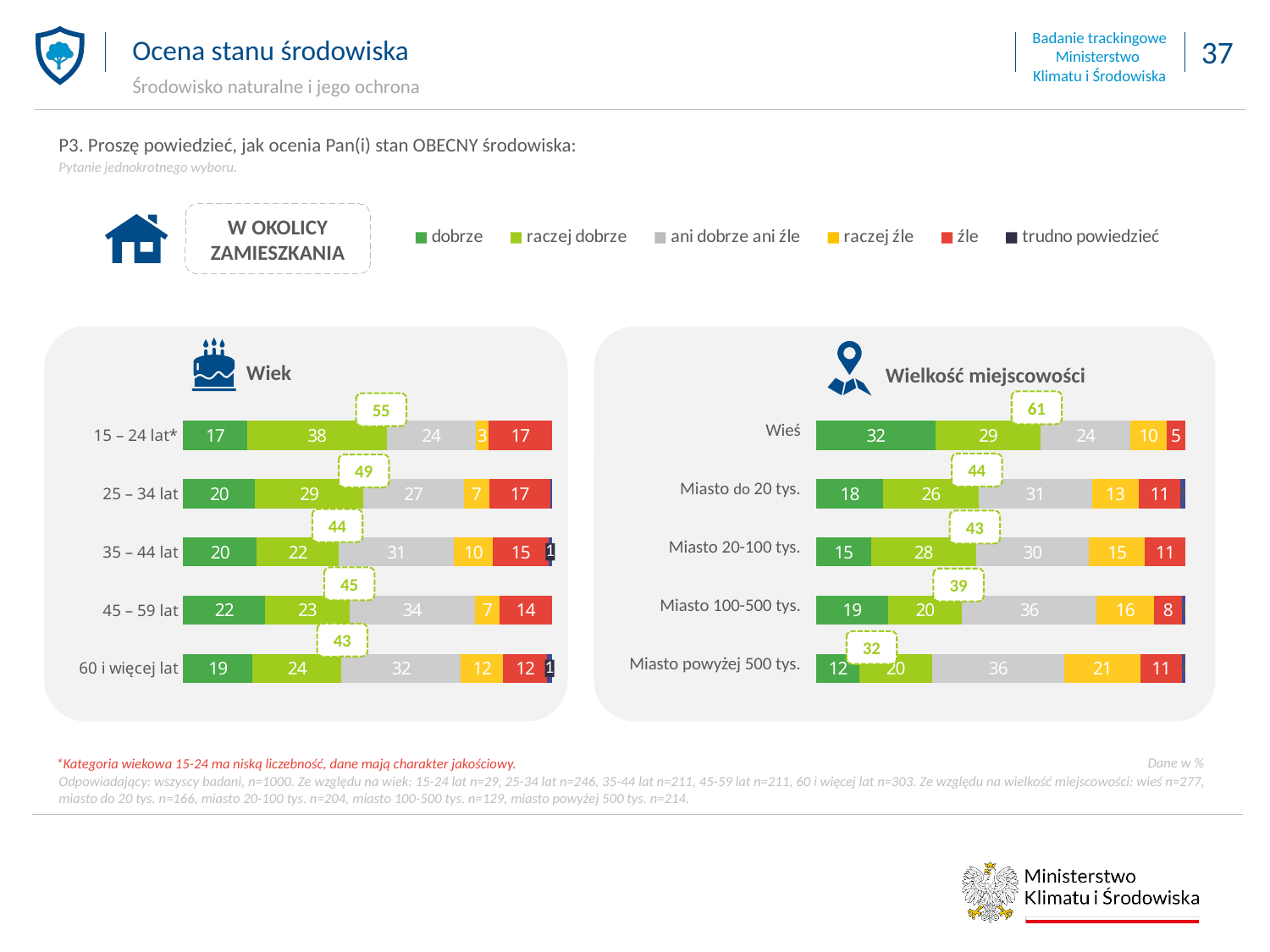
In the 'Wielkość miejscowości' chart, which is larger: the 'ani dobrze ani źle' value for Miasto do 20 tys. or for Miasto 100-500 tys.? Miasto 100-500 tys. What type of chart is the 'Wielkość miejscowości' chart? Stacked bar chart In the 'Wiek' chart, what is the difference between the 'źle' values for 25 – 34 lat and 60 i więcej lat? 5 How many age groups are shown in the 'Wiek' chart? 5 In the 'Wiek' chart, what is the value for 'ani dobrze ani źle' in the 45 – 59 lat group? 34 In the 'Wielkość miejscowości' chart, what is the value for 'dobrze' for Wieś? 32 In the 'Wielkość miejscowości' chart, what is the value for 'raczej źle' for Miasto powyżej 500 tys.? 21 In the 'Wiek' chart, which age group has the lowest value for 'raczej dobrze'? 35 – 44 lat In the 'Wiek' chart, what is the value for 'raczej dobrze' in the 15 – 24 lat* group? 38 In the 'Wielkość miejscowości' chart, which category has the highest value for 'dobrze'? Wieś In the 'Wielkość miejscowości' chart, what is the combined value of 'dobrze' and 'raczej dobrze' shown in the callout for Miasto 20-100 tys.? 43 How many series does the legend list? 6